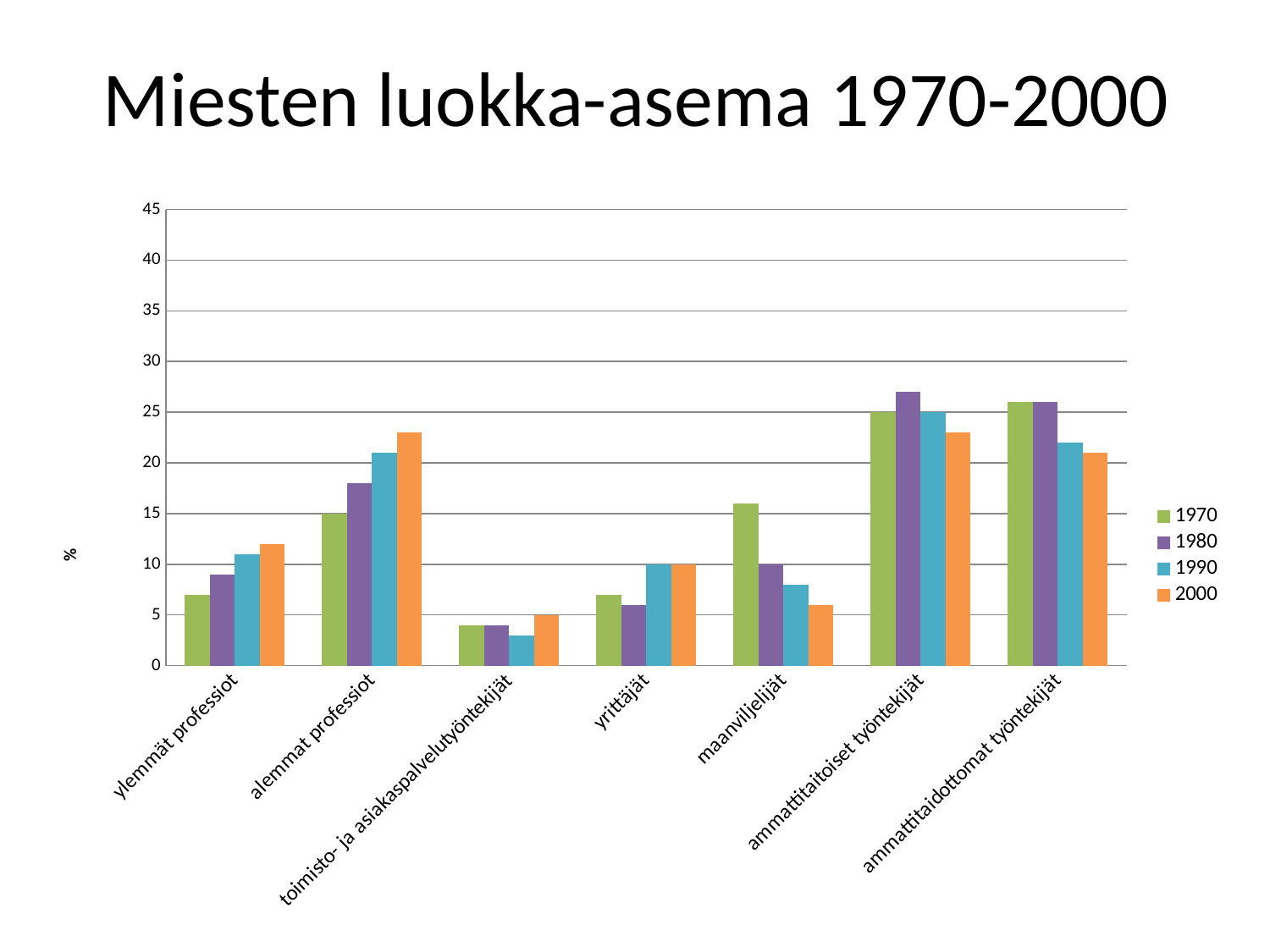
What is the value for alemmat professiot in 1970? 15 Is the value for ammattitaitoiset työntekijät in 1980 greater or less than 25? greater What is the value for ammattitaitoiset työntekijät in 1970? 25 Do the values for ylemmät professiot rise or fall from 1970 to 2000? rise What kind of chart is shown on the slide? bar chart Which category has the lowest value for 1970? toimisto- ja asiakaspalvelutyöntekijät Is the value for ammattitaidottomat työntekijät in 2000 greater or less than 20? greater How many categories are shown on the x axis? 7 Is the value for toimisto- ja asiakaspalvelutyöntekijät in 1990 greater or less than 5? less How many series does the legend list? 4 What is the value for maanviljelijät in 1980? 10 For maanviljelijät, which is larger: the 1970 value or the 2000 value? 1970